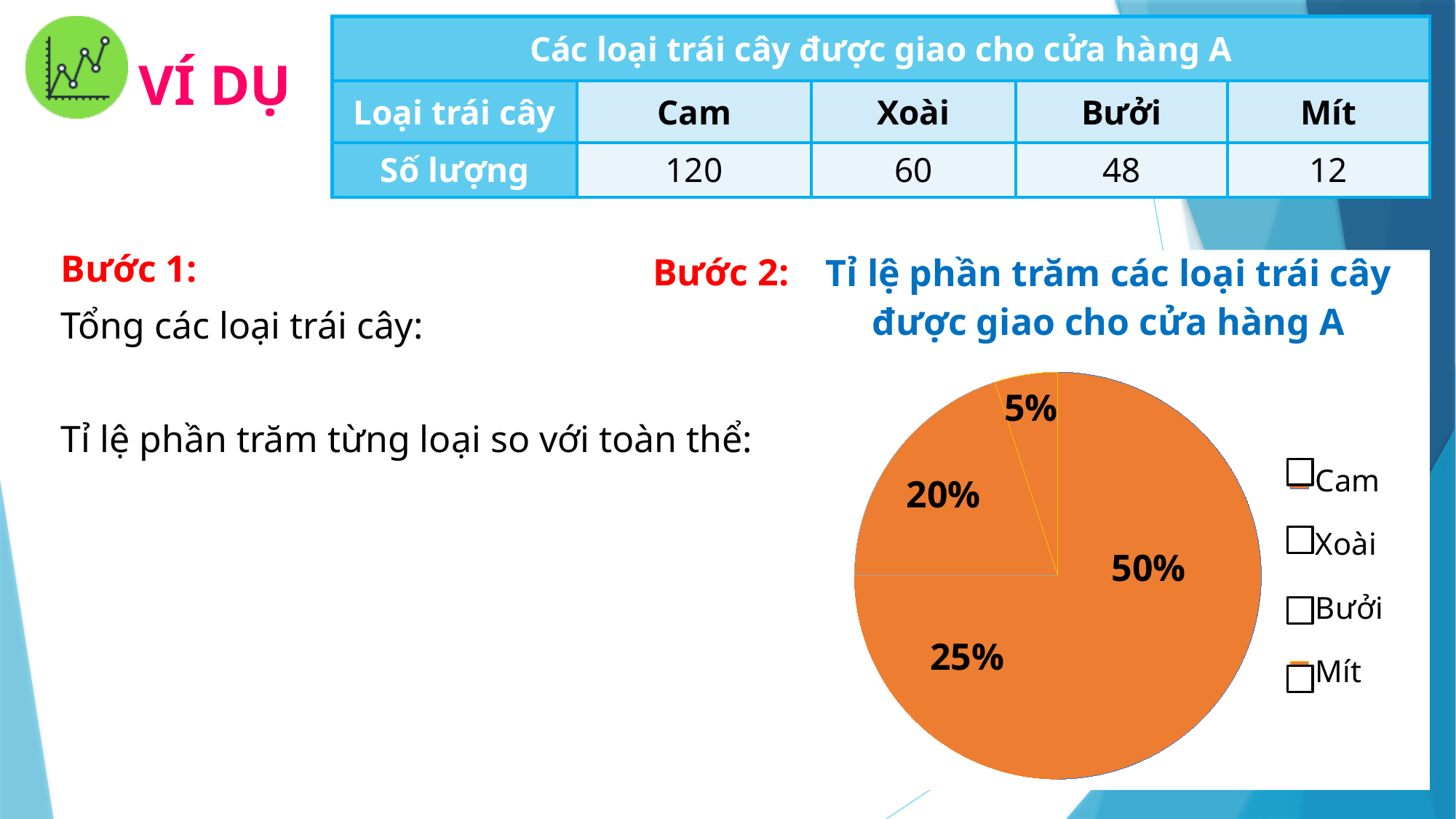
What is the title of the pie chart? Tỉ lệ phần trăm các loại trái cây được giao cho cửa hàng A How many entries does the pie chart's legend list? 4 What is the largest percentage shown on the pie chart? 50% What is the smallest percentage shown on the pie chart? 5% Which category has the largest slice in the pie chart? Cam In the pie chart, what share is shown for Xoài? 25% How many slices does the pie chart have? 4 In the pie chart, what share is shown for Cam? 50% In the pie chart, what share is shown for Mít? 5% What is the difference in percentage points between the 50% slice and the 20% slice in the pie chart? 30 What kind of chart is shown on the slide? pie chart